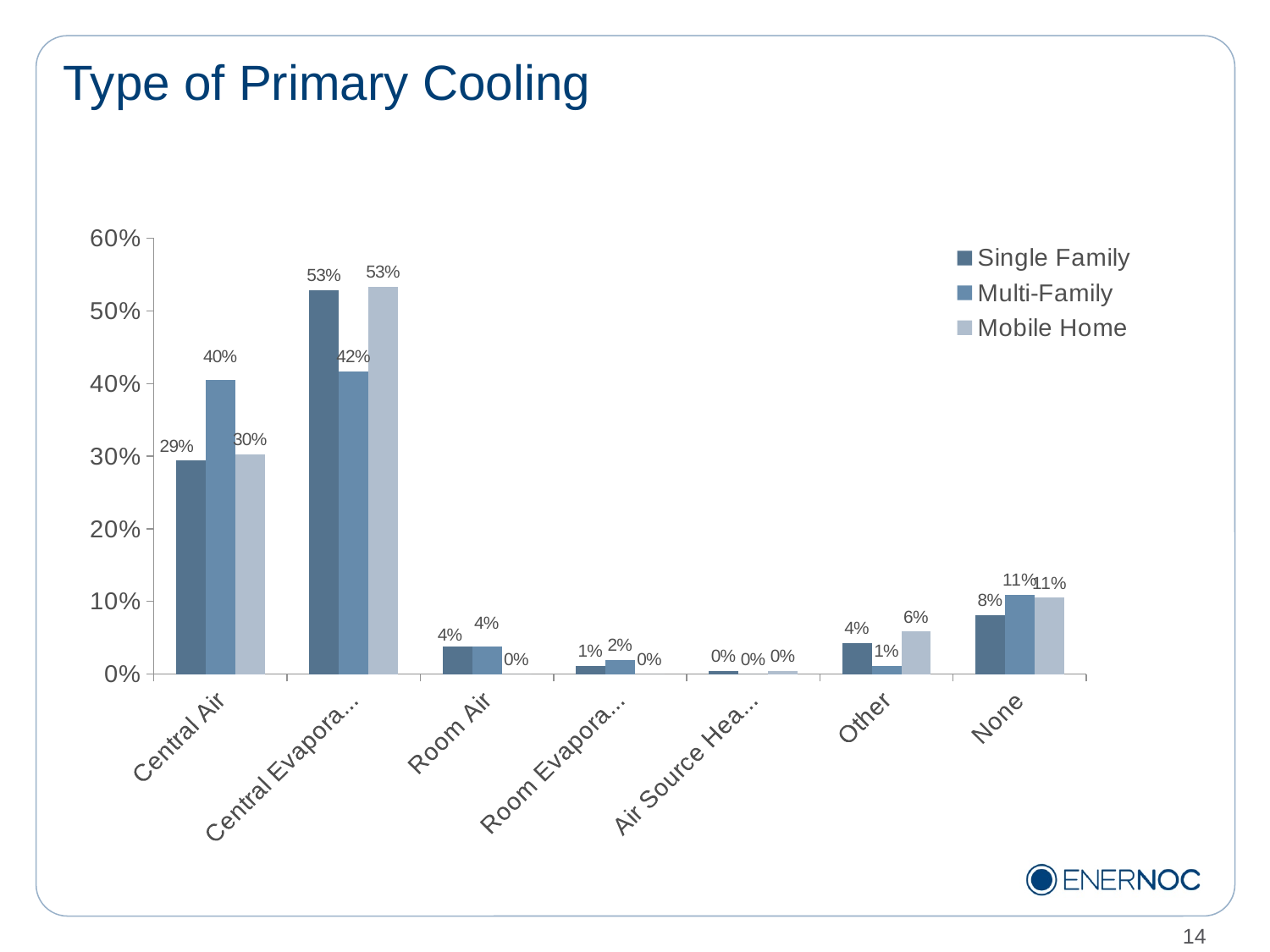
What is the difference between the Multi-Family and Single Family values for Central Air? 11% What is the Mobile Home value for Other? 6% What kind of chart is shown on the slide? Bar chart What is the Multi-Family value for Central Air? 40% How many categories are shown on the x axis? 7 What is the Single Family value for Central Air? 29% How many series does the legend list? 3 What is the Multi-Family value for None? 11% Which series has the lowest value for Other? Multi-Family For Other, which is larger: the Single Family value or the Mobile Home value? Mobile Home Which series has the highest value for Central Air? Multi-Family What is the Mobile Home value for Room Air? 0%